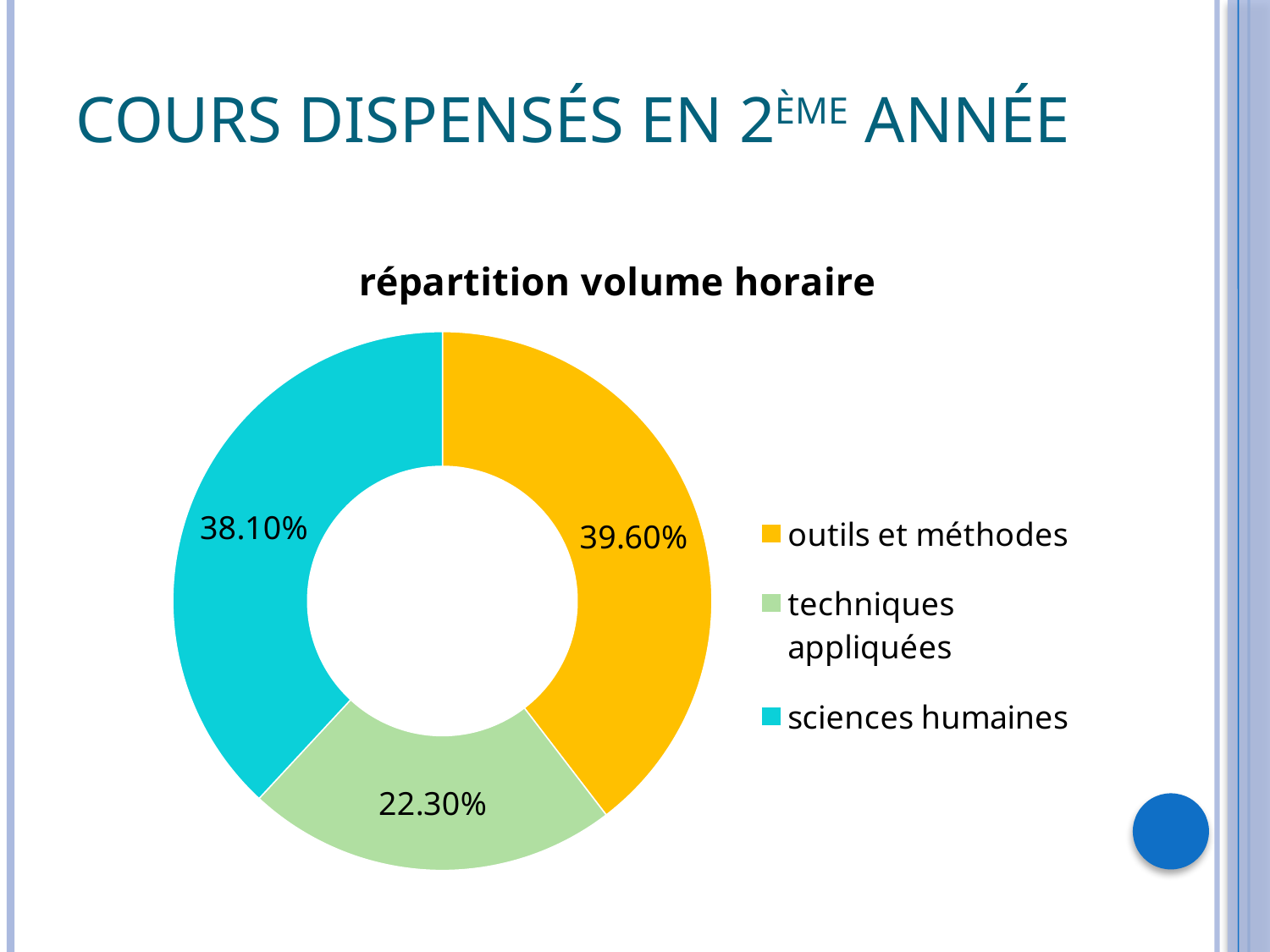
What is the difference in percentage points between outils et méthodes and techniques appliquées? 17.30 How many categories does the chart show? 3 Which category has the smallest share of the chart? techniques appliquées What percentage is shown for techniques appliquées? 22.30% What percentage is shown for outils et méthodes? 39.60% What percentage is shown for sciences humaines? 38.10% What colour represents sciences humaines in the chart? cyan What is the title of the chart? répartition volume horaire Which category has the largest share of the chart? outils et méthodes What type of chart is shown on the slide? doughnut chart What is the difference in percentage points between sciences humaines and techniques appliquées? 15.80 Which is larger, the share for sciences humaines or the share for techniques appliquées? sciences humaines